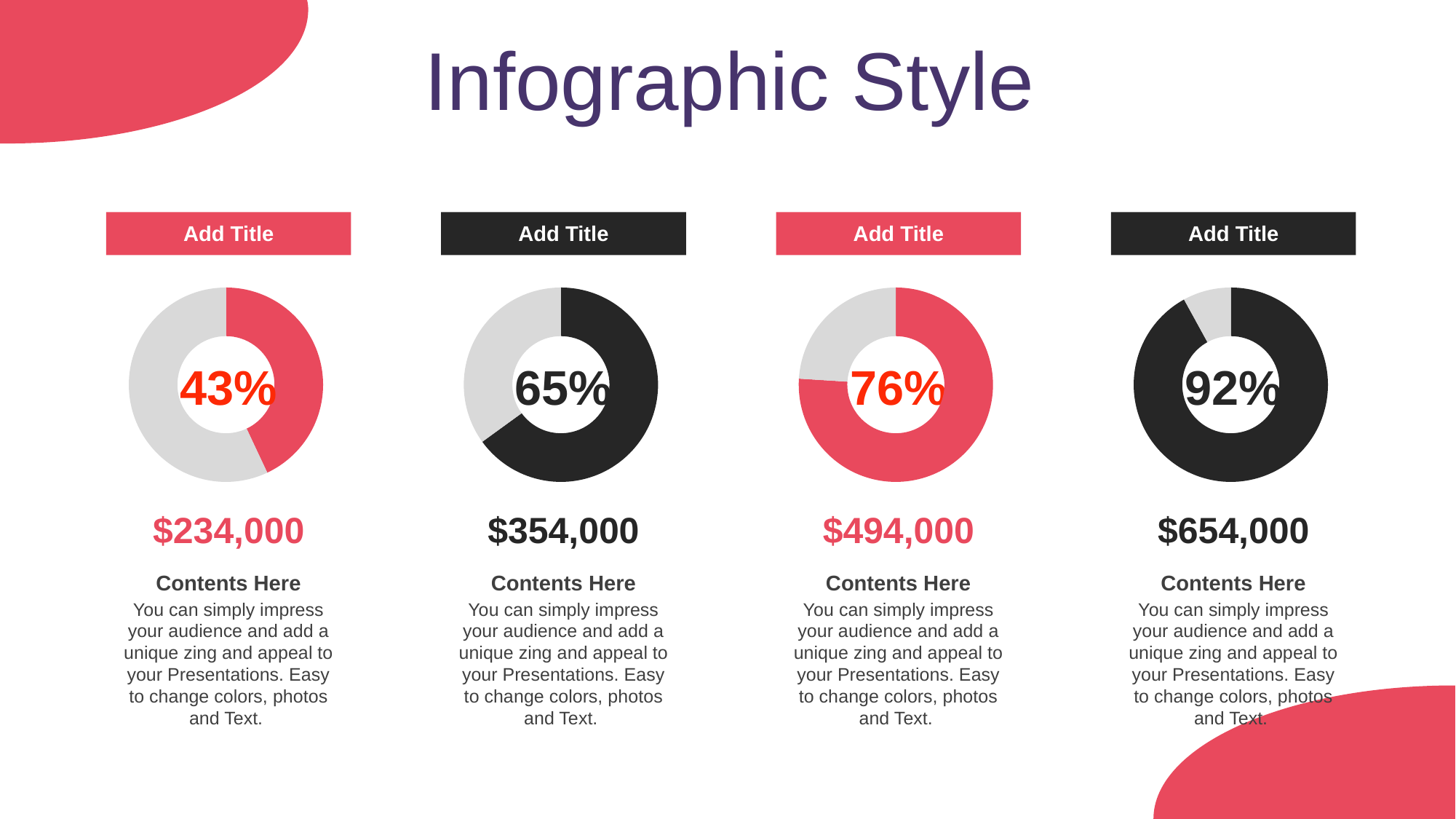
What percentage is shown in the centre of the leftmost donut chart? 43% What kind of chart is shown in each of the four panels on the slide? Donut chart What percentage is shown in the centre of the rightmost donut chart? 92% What percentage is shown in the centre of the third donut chart from the left? 76% What dollar value is printed below the third donut chart from the left? $494,000 Which is larger: the percentage in the second donut chart from the left or the percentage in the third donut chart from the left? The third chart (76%) How many donut charts are on the slide? 4 Which donut chart shows the lowest percentage? The leftmost chart (43%) What percentage is shown in the centre of the second donut chart from the left? 65% Which donut chart shows the highest percentage? The rightmost chart (92%) What colour is the filled portion of the leftmost donut chart? Red What is the difference between the percentage in the rightmost donut chart and the percentage in the leftmost donut chart? 49%